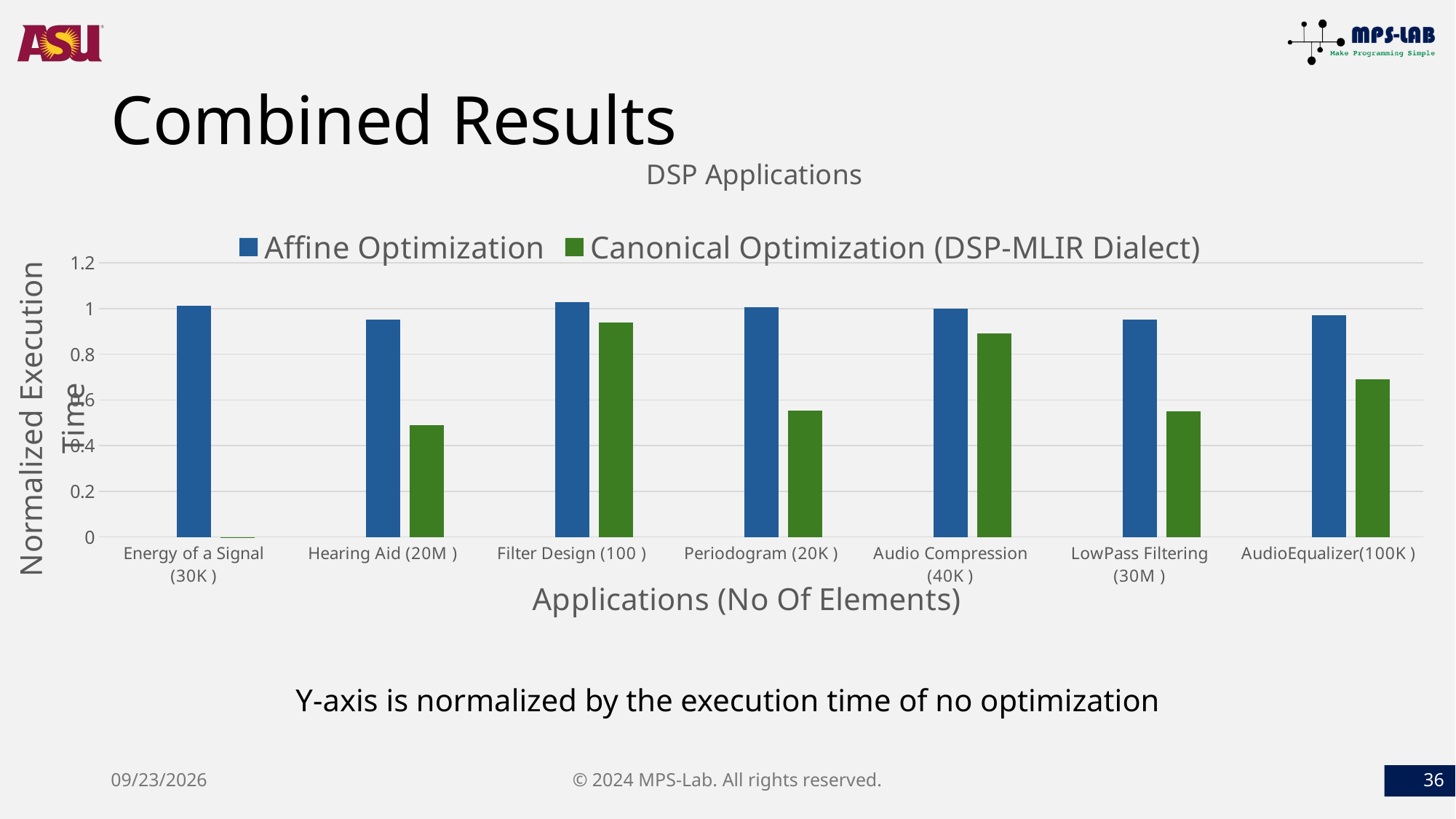
Is the Canonical Optimization (DSP-MLIR Dialect) value for AudioEqualizer(100K ) greater or less than 0.6? greater For Periodogram (20K ), which series has the larger value, Affine Optimization or Canonical Optimization (DSP-MLIR Dialect)? Affine Optimization Is the Canonical Optimization (DSP-MLIR Dialect) value for Audio Compression (40K ) greater or less than 0.8? greater How many series does the legend list? 2 Which has the larger Canonical Optimization (DSP-MLIR Dialect) value, Hearing Aid (20M ) or AudioEqualizer(100K )? AudioEqualizer(100K ) What is the x-axis title of the chart? Applications (No Of Elements) Which application has the lowest Canonical Optimization (DSP-MLIR Dialect) value? Energy of a Signal (30K ) What kind of chart is shown on the slide? Bar chart What is the title of the chart? DSP Applications Which application has the highest Canonical Optimization (DSP-MLIR Dialect) value? Filter Design (100 ) How many applications are shown along the x axis? 7 Is the Canonical Optimization (DSP-MLIR Dialect) value for Hearing Aid (20M ) greater or less than 0.6? less